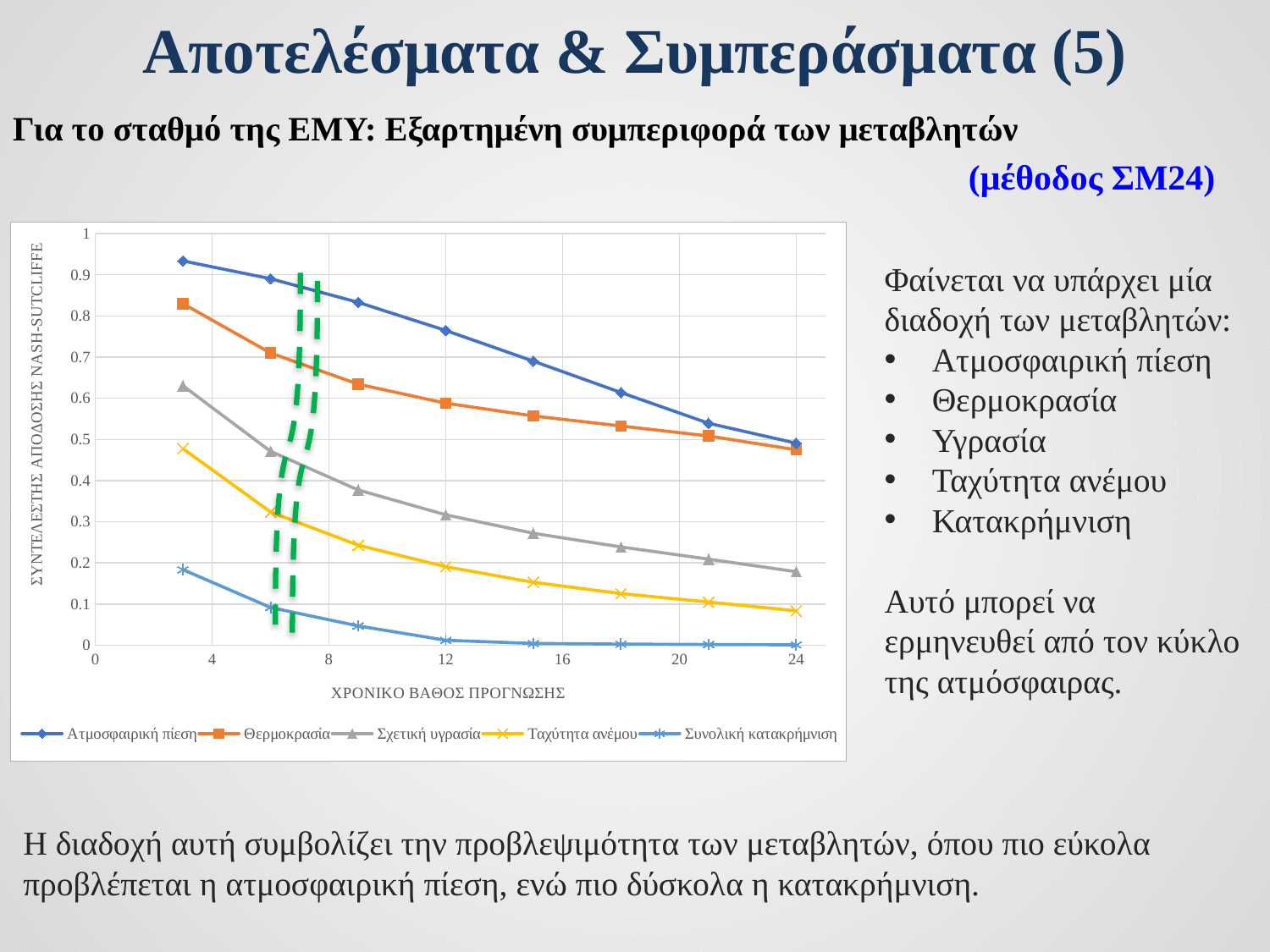
Is the value of Σχετική υγρασία at x = 24 greater or less than 0.2? less Which series is drawn in orange with square markers? Θερμοκρασία Is the value of Ατμοσφαιρική πίεση at x = 3 greater or less than 0.9? greater What is the title of the x axis of the chart? ΧΡΟΝΙΚΟ ΒΑΘΟΣ ΠΡΟΓΝΩΣΗΣ Is the value of Ταχύτητα ανέμου at x = 3 greater or less than 0.4? greater What kind of chart is shown on the slide? line chart How many data points are plotted for the Ατμοσφαιρική πίεση series? 8 Which series has the highest value at x = 3? Ατμοσφαιρική πίεση How many series does the chart legend list? 5 At x = 12, which is larger: the value for Θερμοκρασία or the value for Σχετική υγρασία? Θερμοκρασία Which series has the lowest values across the whole chart? Συνολική κατακρήμνιση Do the values of the Θερμοκρασία series rise or fall as the forecast horizon (x axis) increases? fall